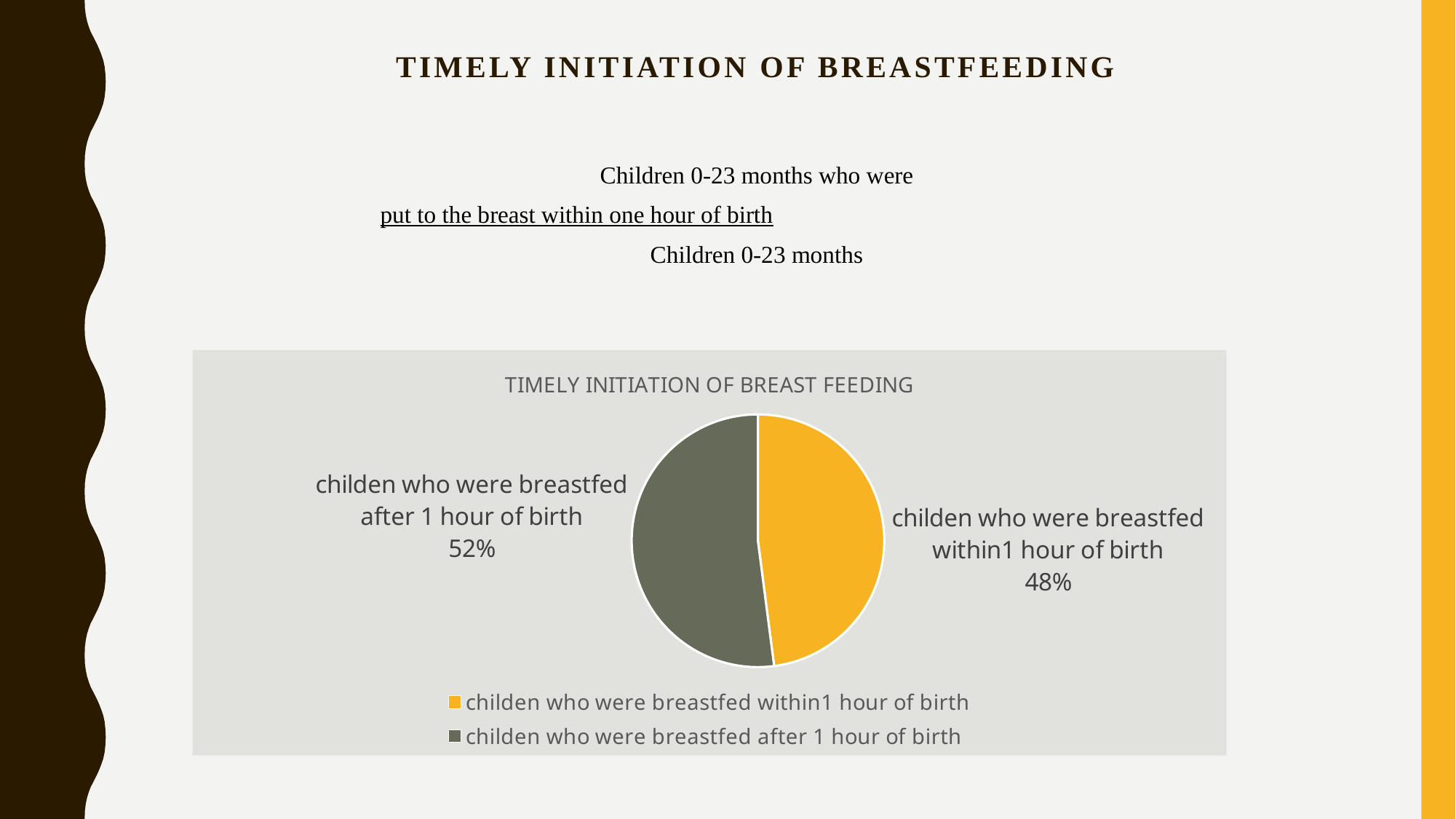
What share of the pie is for children who were breastfed after 1 hour of birth? 52% Which slice of the pie is the smallest? childen who were breastfed within1 hour of birth What is the title of the chart? TIMELY INITIATION OF BREAST FEEDING Which is larger: the slice for children breastfed within 1 hour of birth or the slice for children breastfed after 1 hour of birth? childen who were breastfed after 1 hour of birth How many slices does the pie chart have? 2 Which slice of the pie is the largest? childen who were breastfed after 1 hour of birth What is the difference in percentage points between the slice for children breastfed after 1 hour of birth and the slice for children breastfed within 1 hour of birth? 4 percentage points What share of the pie is for children who were breastfed within 1 hour of birth? 48% What kind of chart is shown on the slide? pie chart What colour is the slice for children who were breastfed within 1 hour of birth? yellow Is the share for children breastfed within 1 hour of birth greater or less than 50%? less How many entries does the chart legend list? 2